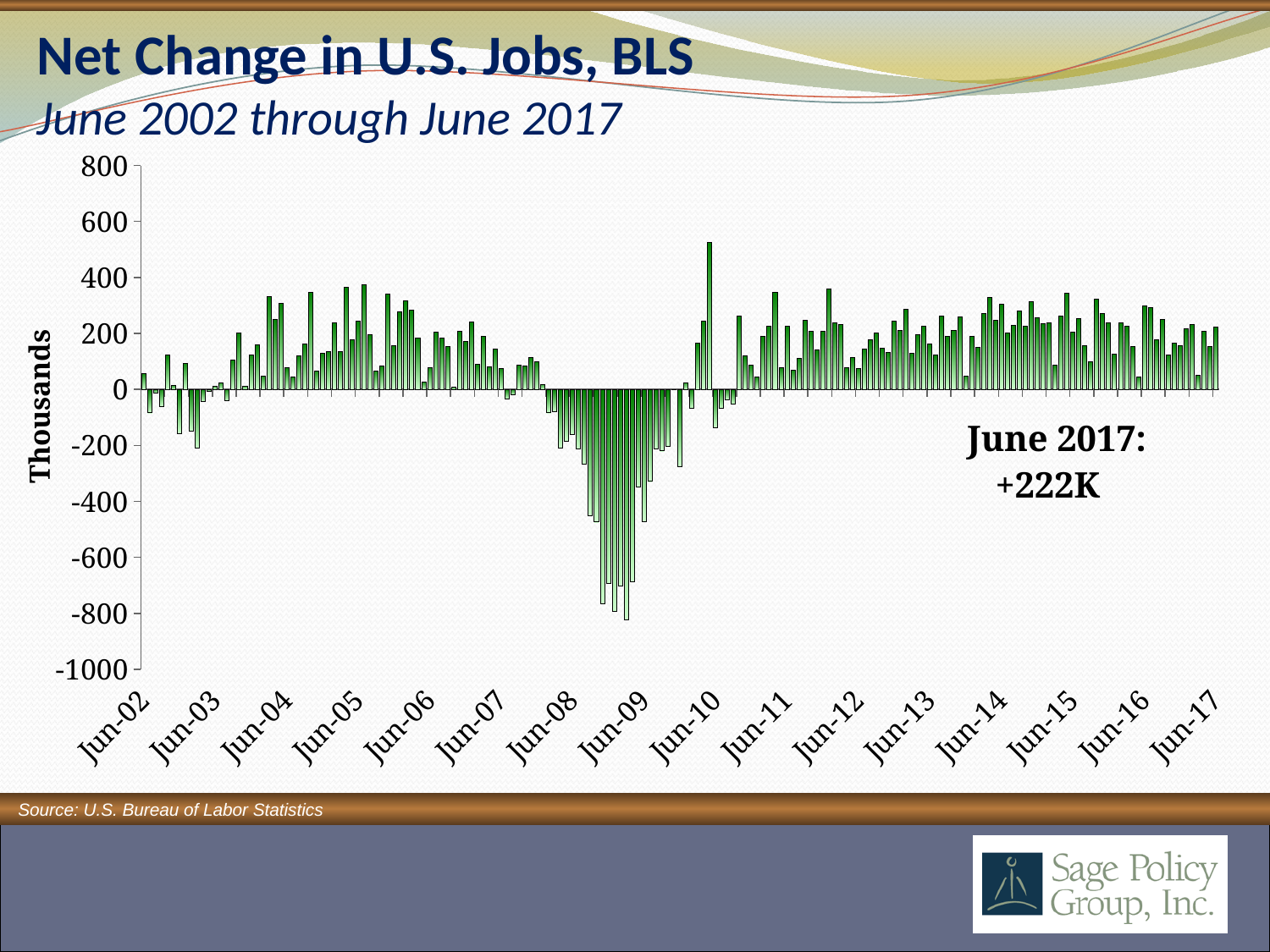
Is the value for June 2017 greater or less than 200 thousand? greater Between which two x-axis labels does the chart reach its lowest value? Jun-08 and Jun-09 What is the net change in U.S. jobs for June 2017 according to the annotation on the chart? +222K Is the lowest bar on the chart, located between Jun-08 and Jun-09, greater or less than -600 thousand? less Are the bars between Jun-08 and Jun-09 mostly positive or negative? negative Is the tallest positive bar, located shortly before Jun-10, greater or less than 400 thousand? greater How many labels are shown on the x axis? 16 What is the label on the y axis? Thousands Which is larger: the bar for June 2017 or the tallest bar shortly before Jun-10? the tallest bar shortly before Jun-10 What is the highest tick value shown on the y axis? 800 What kind of chart is shown on the slide? bar chart